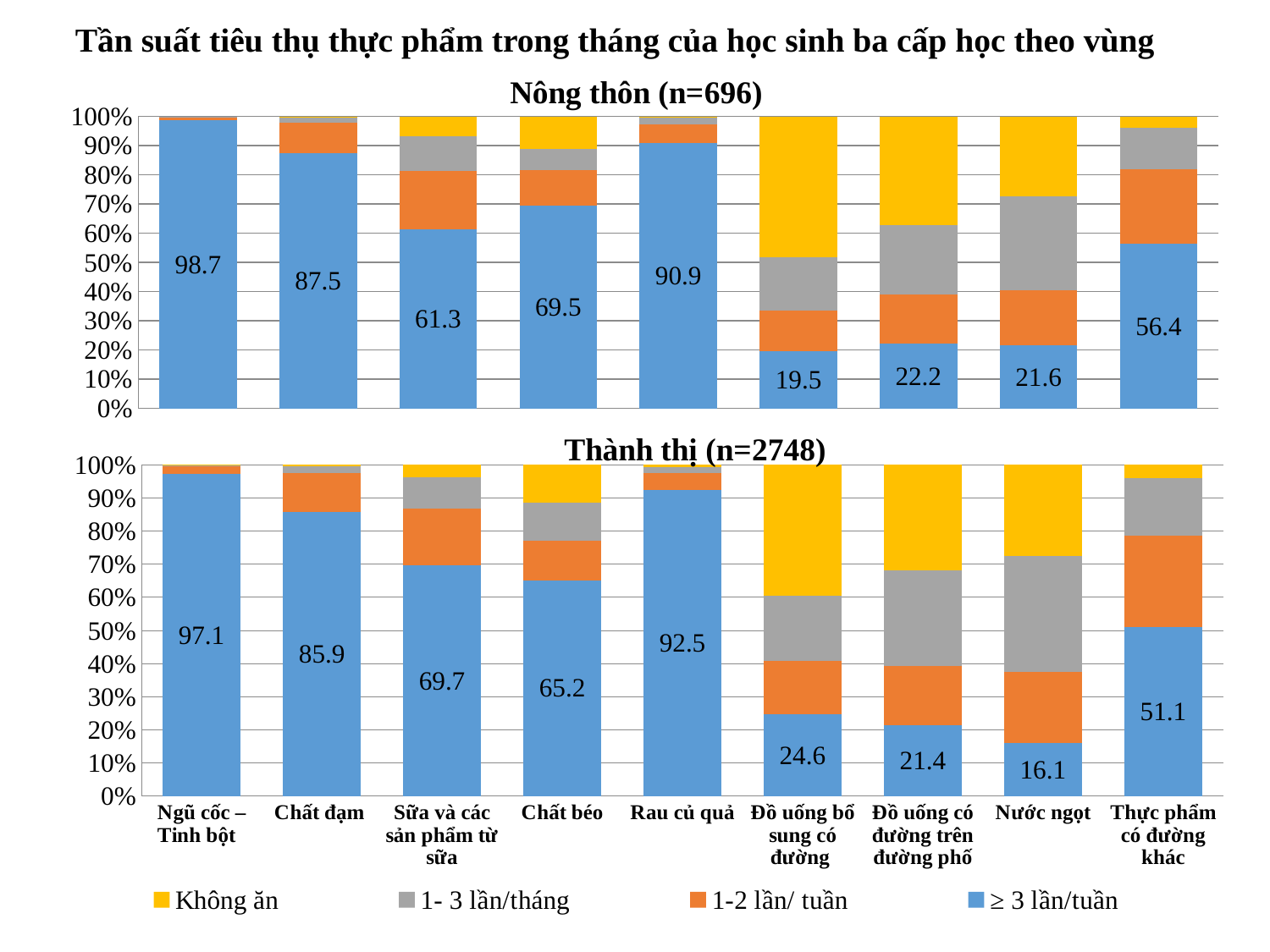
For Sữa và các sản phẩm từ sữa, is the ≥ 3 lần/tuần value higher in the Nông thôn chart or the Thành thị chart? Thành thị In the Thành thị (n=2748) chart, what is the value of ≥ 3 lần/tuần for Nước ngọt? 16.1 In the Thành thị (n=2748) chart, which food group has the lowest ≥ 3 lần/tuần value? Nước ngọt In the Nông thôn (n=696) chart, what is the difference between the ≥ 3 lần/tuần values for Chất đạm and Chất béo? 18 In the Nông thôn (n=696) chart, which food group has the lowest ≥ 3 lần/tuần value? Đồ uống bổ sung có đường Which colour represents Không ăn in the legend? Yellow In the Nông thôn (n=696) chart, what is the value of ≥ 3 lần/tuần for Ngũ cốc – Tinh bột? 98.7 In the Thành thị (n=2748) chart, what is the difference between the ≥ 3 lần/tuần values for Ngũ cốc – Tinh bột and Rau củ quả? 4.6 In the Nông thôn (n=696) chart, which food group has the highest ≥ 3 lần/tuần value? Ngũ cốc – Tinh bột How many series does the legend list? 4 What kind of chart is the Nông thôn (n=696) chart? Stacked bar chart How many food groups are shown on the x axis of the Thành thị (n=2748) chart? 9